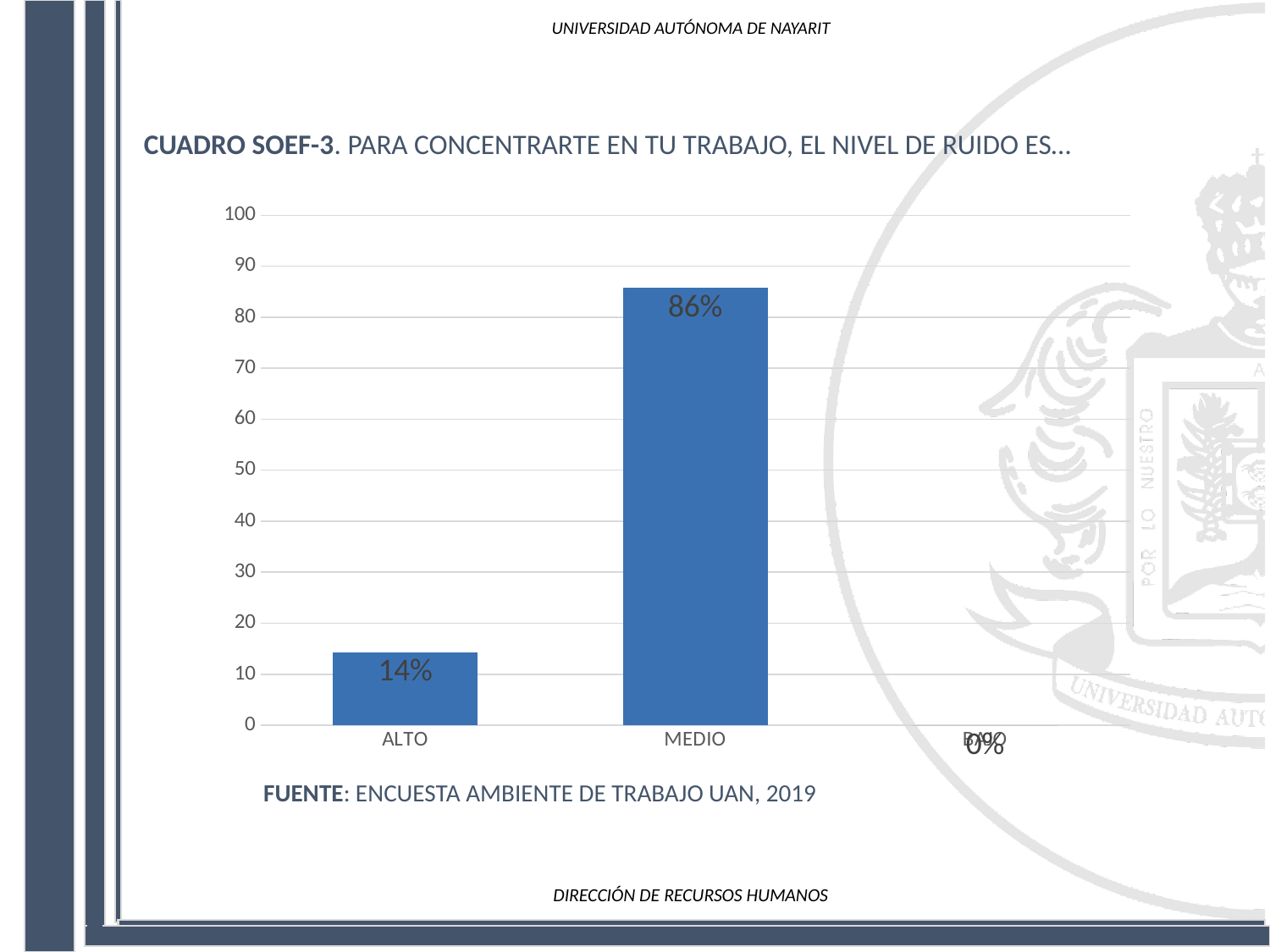
What is the highest value shown on the y axis? 100 Is the value for MEDIO greater or less than 80? greater What is the value for ALTO? 14% What is the difference between the values for MEDIO and ALTO? 72% Which category has the highest value? MEDIO How many categories are shown on the x axis? 3 What kind of chart is shown on the slide? bar chart What is the title of the chart? CUADRO SOEF-3. PARA CONCENTRARTE EN TU TRABAJO, EL NIVEL DE RUIDO ES… What is the value for MEDIO? 86% Which is larger, the value for ALTO or the value for MEDIO? MEDIO Is the value for ALTO greater or less than 20? less